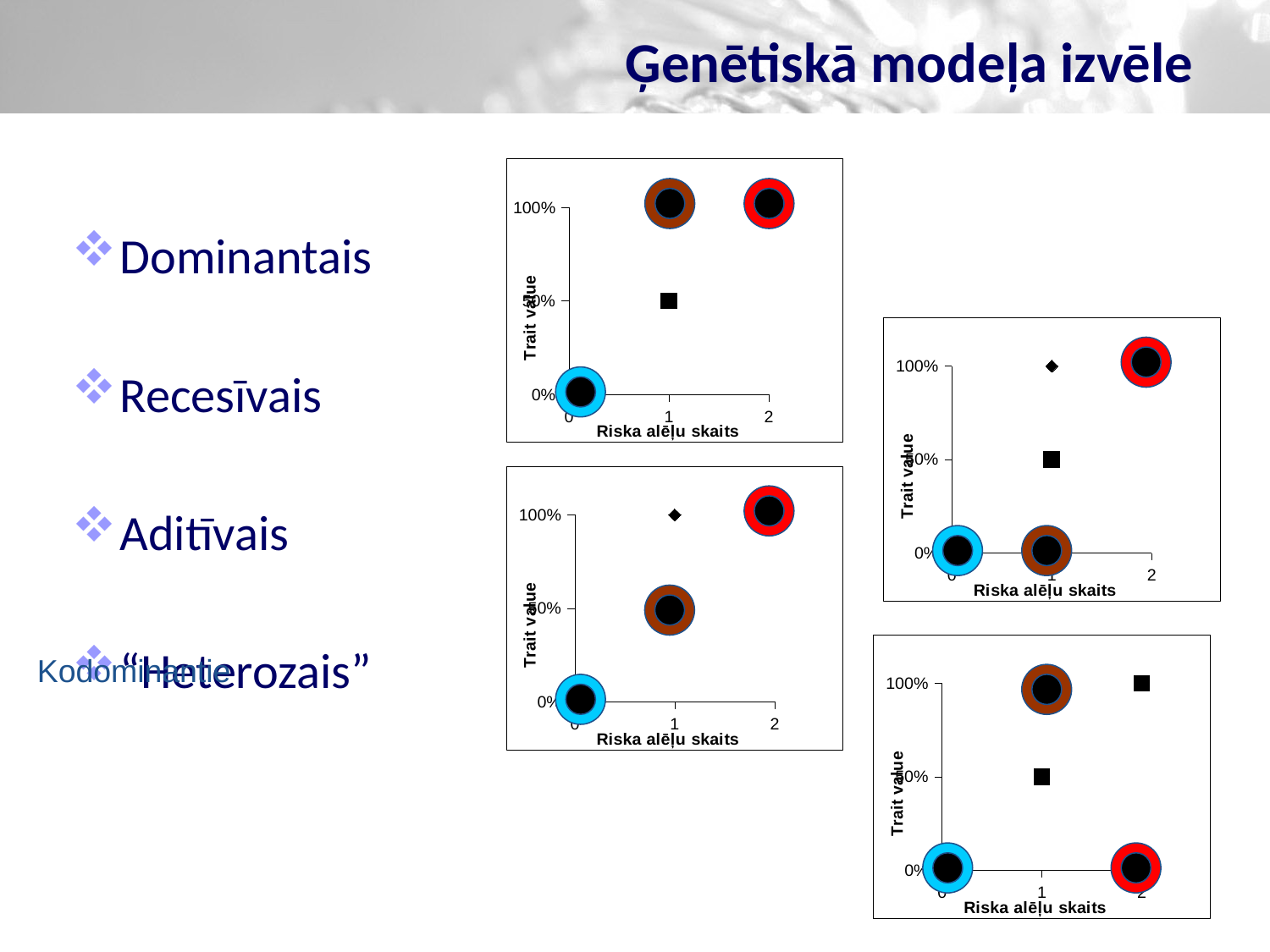
In the top-right chart, what is the trait value of the large circle marker at 1 risk allele? 0% In the bottom chart of the middle column, what is the trait value of the large circle marker at 1 risk allele? 50% How many large circle markers are plotted in the top-right chart? 3 In the bottom chart of the middle column, what is the difference in trait value between the large circle markers at 2 and 1 risk alleles? 50% In the top chart of the middle column, what is the trait value of the large circle marker at 1 risk allele? 100% What is the x-axis title of the bottom-right chart? Riska alēļu skaits In the top chart of the middle column, what is the trait value of the large circle marker at 0 risk alleles? 0% In the bottom chart of the middle column, do the large circle markers rise or fall as the number of risk alleles increases from 0 to 2? rise In the bottom-right chart, which number of risk alleles has the highest trait value among the large circle markers? 1 In the bottom-right chart, what is the trait value of the large circle marker at 2 risk alleles? 0% In the top-right chart, what is the trait value of the large circle marker at 2 risk alleles? 100% What kind of chart is the top chart in the middle column of the slide? scatter chart